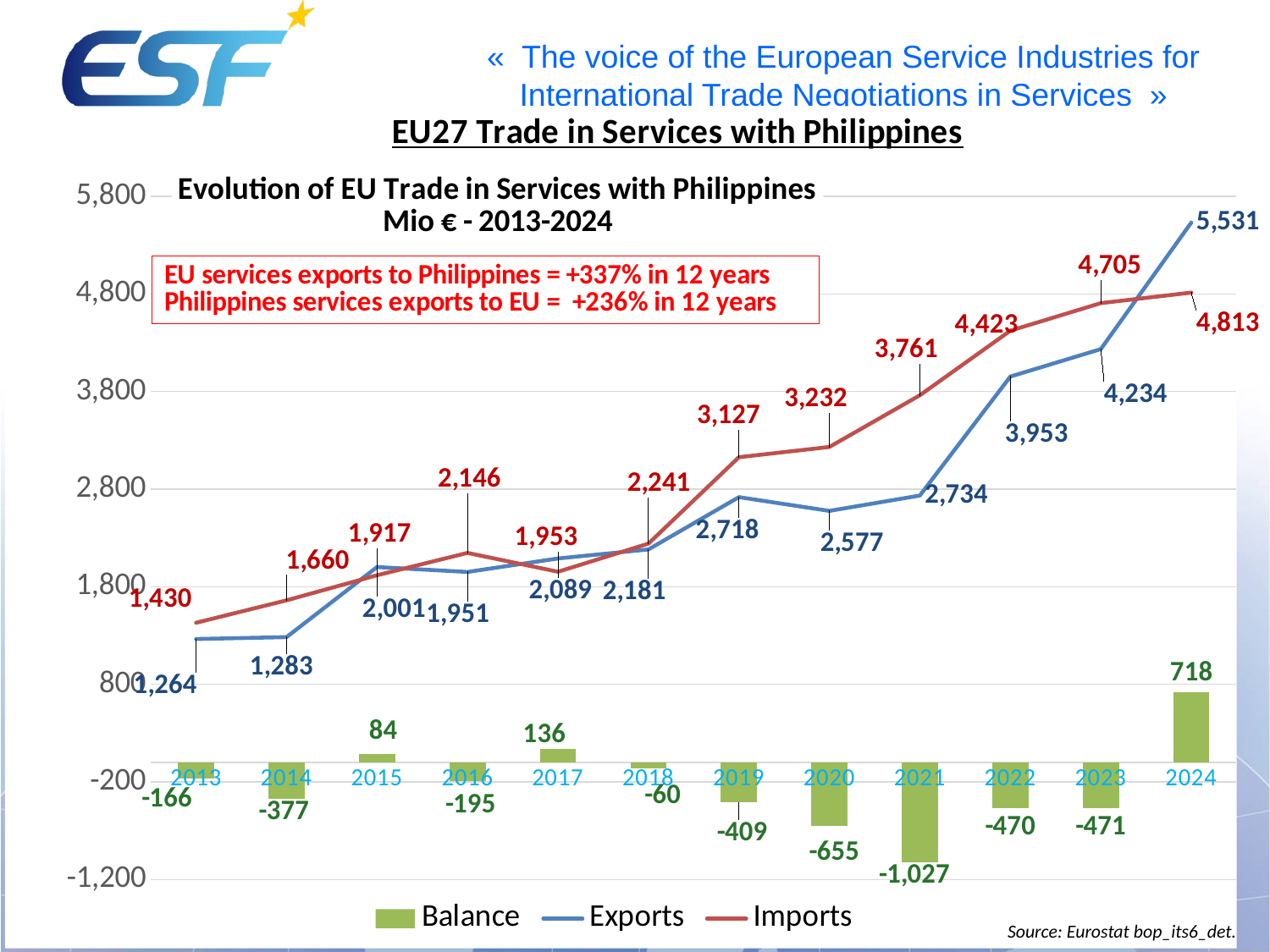
Is the value of Imports in 2023 greater or less than 3,800? greater Which is larger in 2022, Exports or Imports? Imports In which year is the Balance highest? 2024 How many years are shown on the x axis? 12 What is the value of Exports in 2024? 5,531 What colour is the Imports line? Red How many series does the legend list? 3 What is the overall trend of Exports from 2013 to 2024? Rising What is the Balance value for 2021? -1,027 In which year is the Balance lowest? 2021 What is the value of Imports in 2019? 3,127 What is the difference between Exports and Imports in 2024? 718